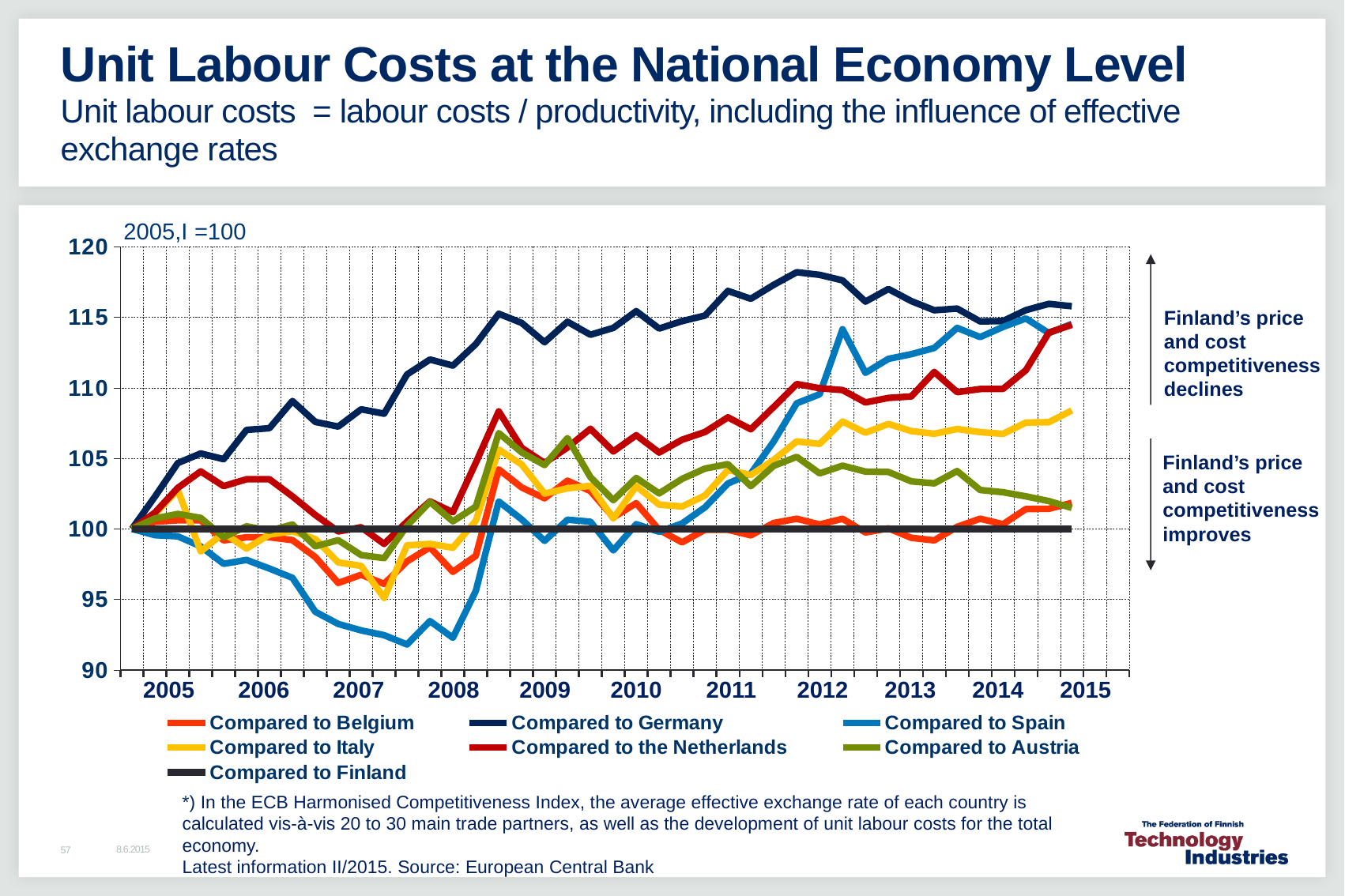
Is the value for Compared to Germany in 2012 greater or less than 115? greater At what constant value does the Compared to Finland line run? 100 Is the value for Compared to Belgium at the end of the chart (2015) greater or less than 105? less Does the Compared to Germany line rise or fall from 2005 to 2015 overall? rise In 2007, which is larger: Compared to Germany or Compared to Spain? Compared to Germany Is the value for Compared to Spain in 2007 greater or less than 95? less Which series is the lowest around 2007? Compared to Spain What base-year note is printed above the chart's y axis? 2005,I =100 What type of chart is shown on the slide? line chart Which series is the highest at the right end of the chart (2015)? Compared to Germany How many series does the legend list? 7